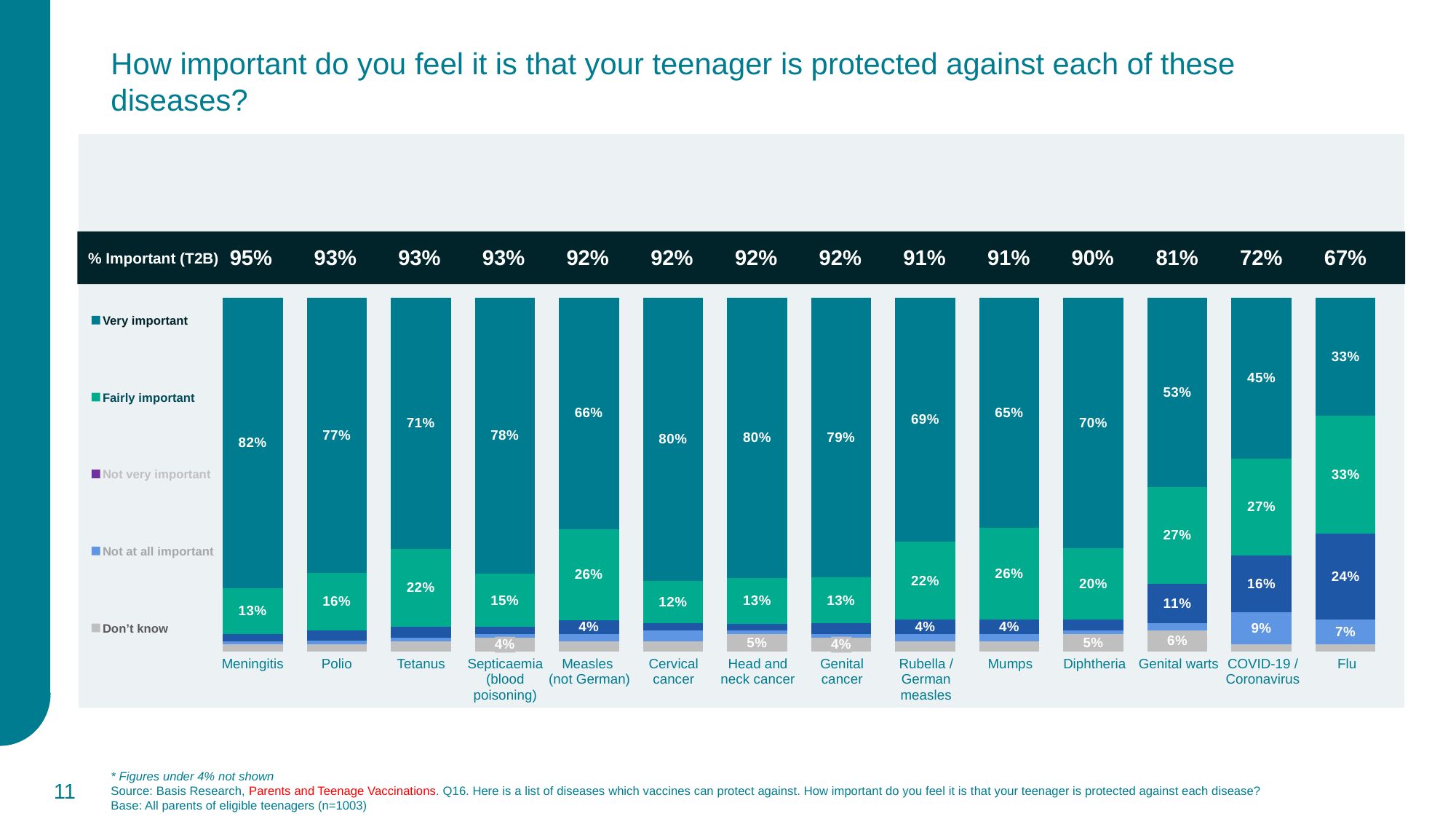
Which has a higher 'Very important' percentage, Polio or Tetanus? Polio What is the difference in percentage points between the 'Very important' values for Cervical cancer and Measles (not German)? 14 percentage points How many diseases are shown along the x axis of the chart? 14 How many response categories does the legend list? 5 What type of chart is shown on the slide? Stacked bar chart Which disease has the highest 'Very important' percentage? Meningitis What is the % Important (T2B) figure shown for Flu? 67% What is the Don't know percentage shown for Genital warts? 6% What is the % Important (T2B) figure shown for COVID-19 / Coronavirus? 72% What percentage of parents said it is fairly important that their teenager is protected against Flu? 33% Which disease has the lowest 'Very important' percentage? Flu What percentage of parents said it is very important that their teenager is protected against Meningitis? 82%